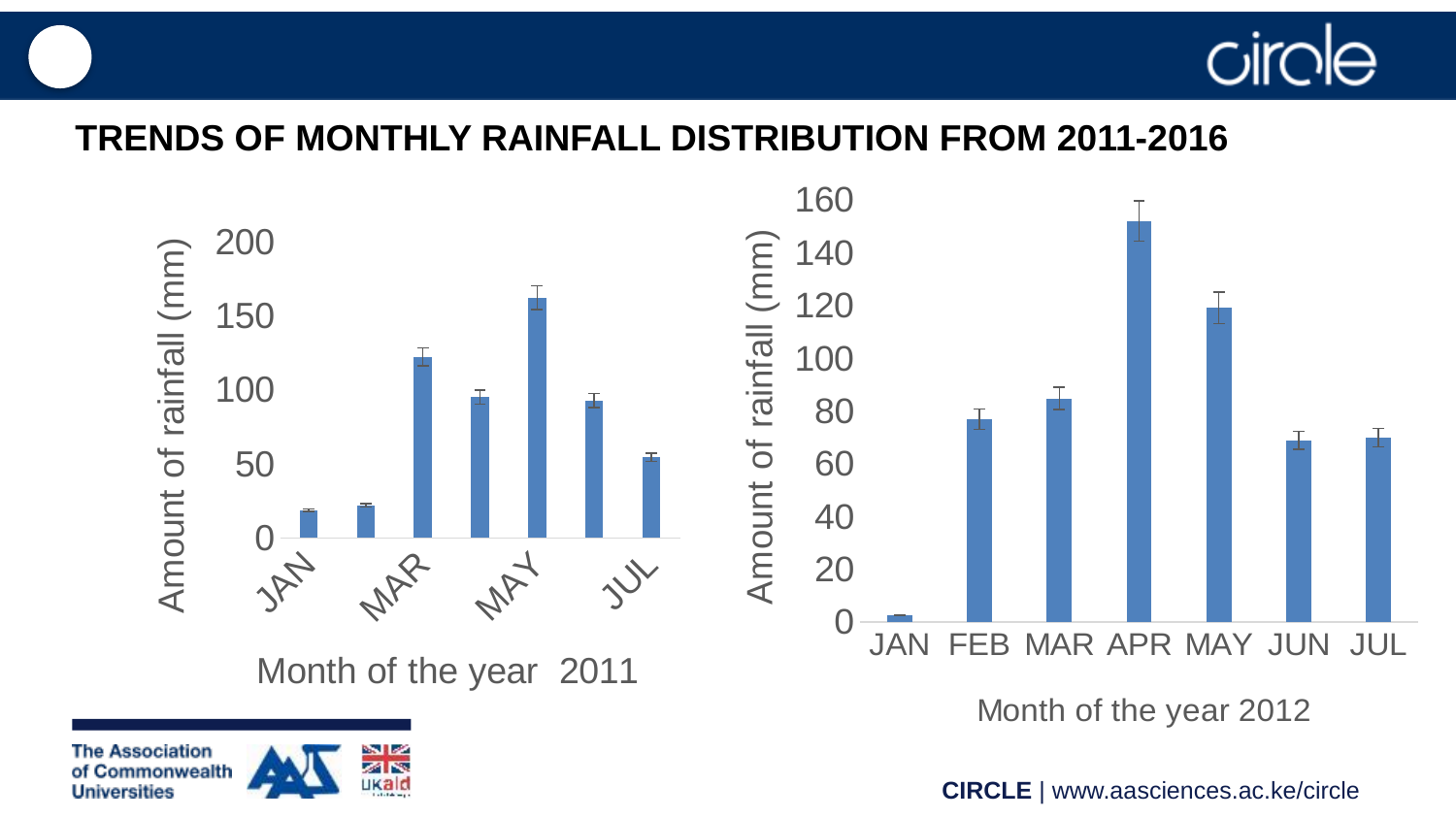
In the 2011 chart on the left, is the value for MAY greater or less than 150? greater How many bars are plotted in the 2012 chart on the right? 7 In the 2012 chart on the right, do the values rise or fall from JAN to APR? rise In the 2012 chart on the right, which month has the lowest amount of rainfall? JAN What is the y-axis label of the 2012 chart on the right? Amount of rainfall (mm) In the 2012 chart on the right, is the value for JAN greater or less than 20? less In the 2012 chart on the right, which month has the highest amount of rainfall? APR What kind of chart is the 2011 chart on the left of the slide? bar chart In the 2012 chart on the right, is the value for APR greater or less than 140? greater In the 2012 chart on the right, which is larger, the value for APR or the value for MAY? APR In the 2011 chart on the left, which labelled month has the highest amount of rainfall? MAY